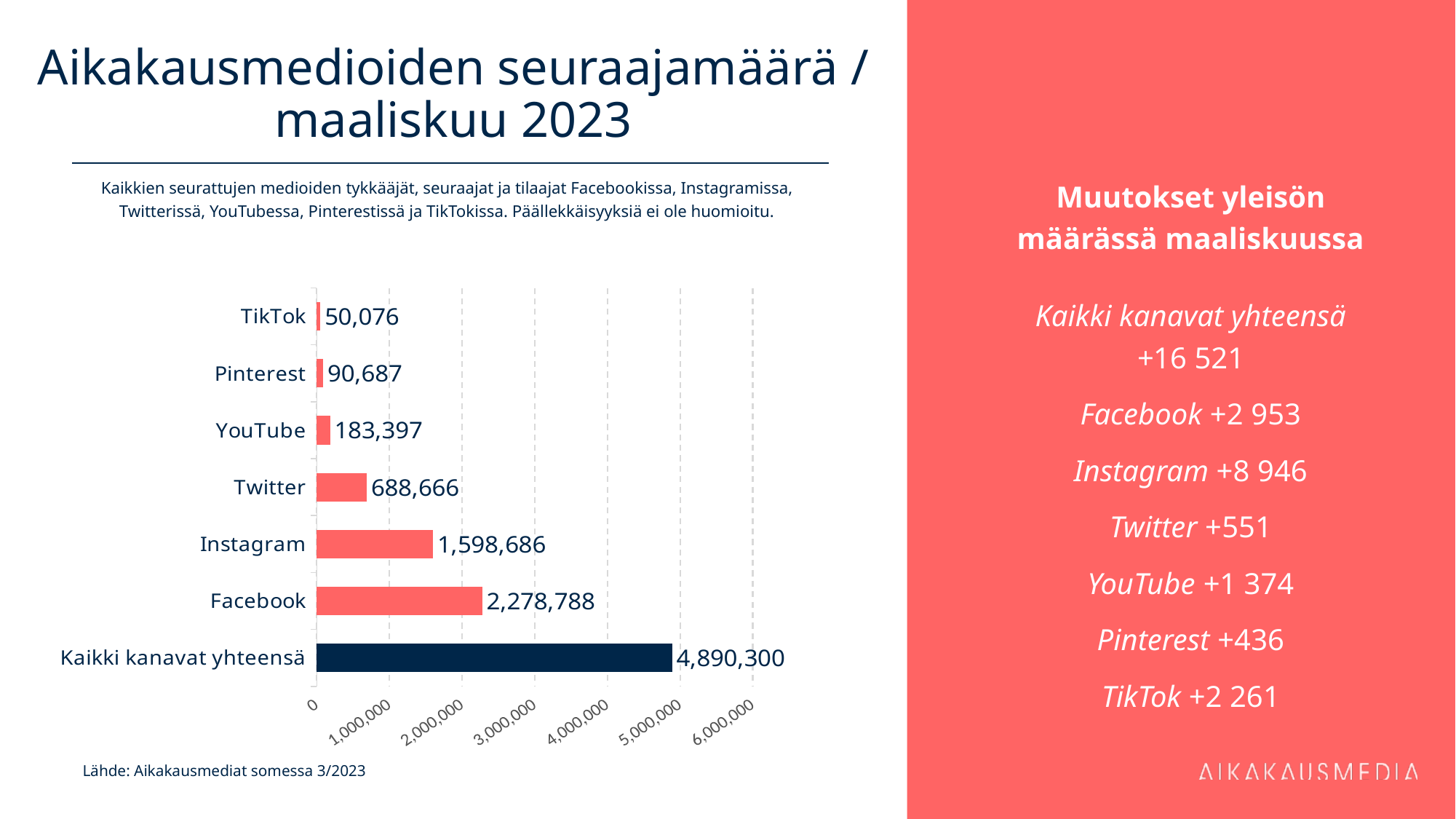
What kind of chart is shown on the slide? bar chart What is the difference between the values for Facebook and Instagram? 680,102 How many bars are plotted in the chart? 7 What is the value for Facebook? 2,278,788 Which category has the lowest value? TikTok Which individual channel (excluding the total bar) has the highest value? Facebook What is the value for Kaikki kanavat yhteensä? 4,890,300 What is the value for TikTok? 50,076 What is the value for Twitter? 688,666 Is the value for Instagram greater or less than 2,000,000? less Which is larger, the value for Pinterest or the value for YouTube? YouTube What is the difference between the values for Twitter and YouTube? 505,269